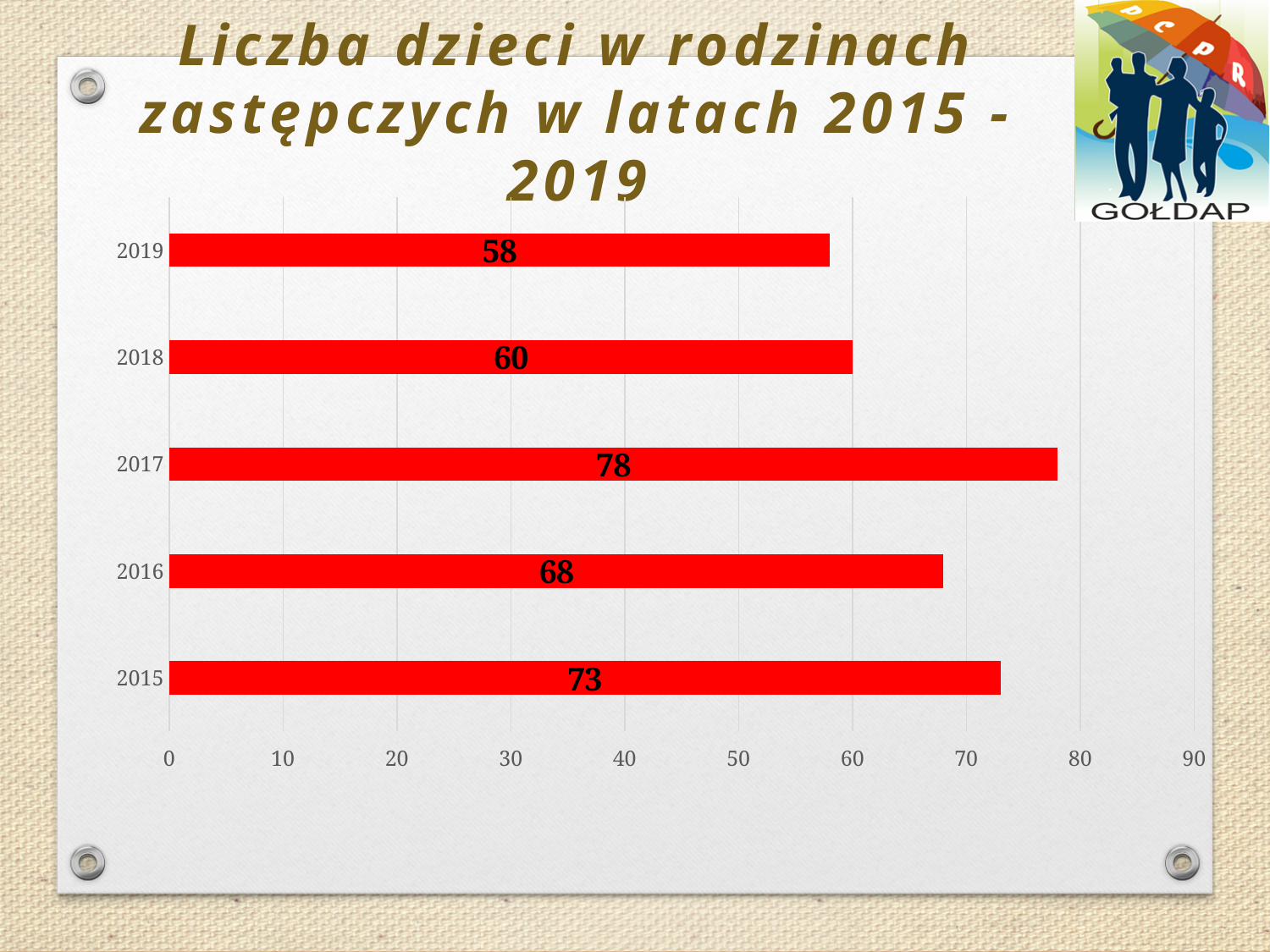
What is the difference between the values for 2017 and 2019? 20 What is the value for 2017? 78 What is the value for 2019? 58 Which is larger, the value for 2016 or the value for 2018? 2016 How many years are shown in the chart? 5 What is the value for 2015? 73 What is the title of the chart? Liczba dzieci w rodzinach zastępczych w latach 2015 - 2019 What is the difference between the values for 2015 and 2016? 5 What kind of chart is shown on the slide? bar chart Which year has the lowest value? 2019 Is the value for 2018 greater or less than 50? greater Which year has the highest value? 2017